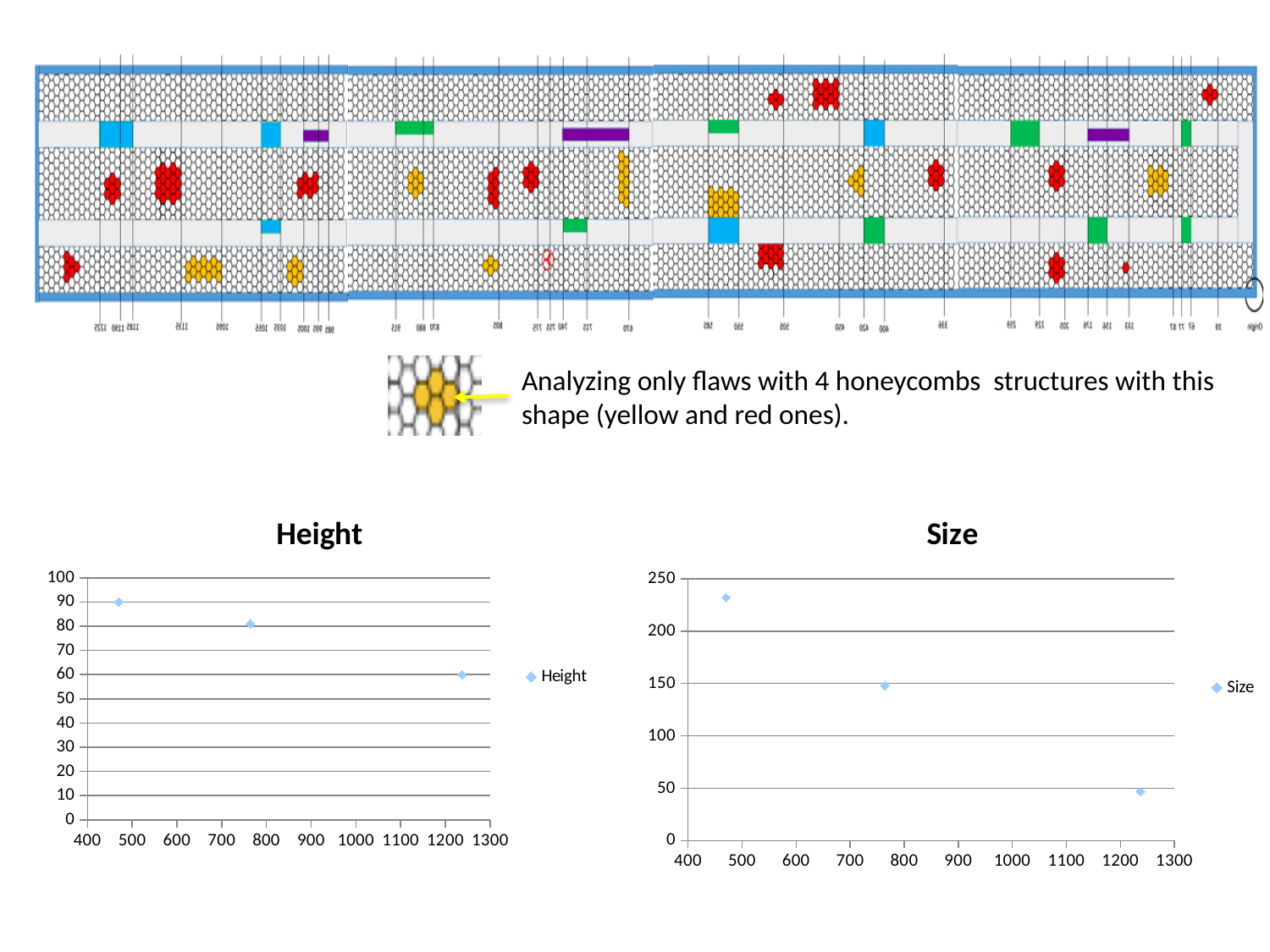
In the Size chart, do the values rise or fall as the x-axis value increases? fall What kind of chart is the Height chart? scatter chart In the Height chart, which has the higher value, the leftmost point or the rightmost point? the leftmost point What is the legend entry shown in the Height chart? Height In the Size chart, is the value of the leftmost point greater or less than 200? greater How many series does the legend of the Size chart list? 1 In the Size chart, is the value of the rightmost point greater or less than 100? less In the Height chart, is the value of the rightmost point greater or less than 70? less How many data points are plotted in the Size chart? 3 How many data points are plotted in the Height chart? 3 In the Height chart, do the values rise or fall as the x-axis value increases? fall What kind of chart is the Size chart? scatter chart